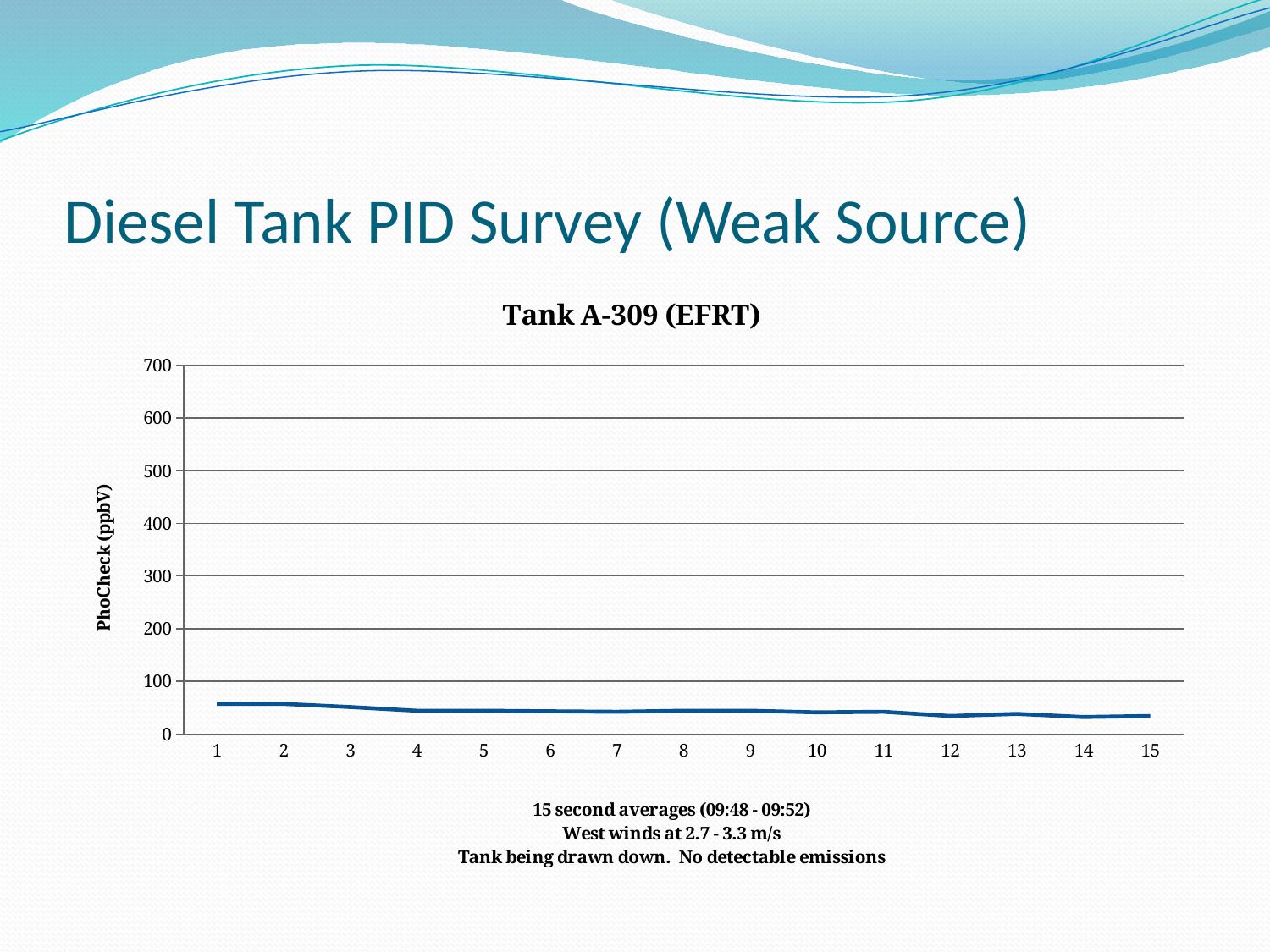
Which is larger, the value at point 1 or the value at point 15? point 1 What is the highest value shown on the vertical axis? 700 Do the values generally rise or fall from point 1 to point 15? fall Is the value at point 8 greater or less than 100? less Which is larger, the value at point 2 or the value at point 12? point 2 Is the value at point 15 greater or less than 100? less Is the value at point 1 greater or less than 100? less How many points are plotted along the x axis? 15 What is the title of the chart? Tank A-309 (EFRT) What kind of chart is shown on the slide? line chart What is the label of the vertical axis? PhoCheck (ppbV)